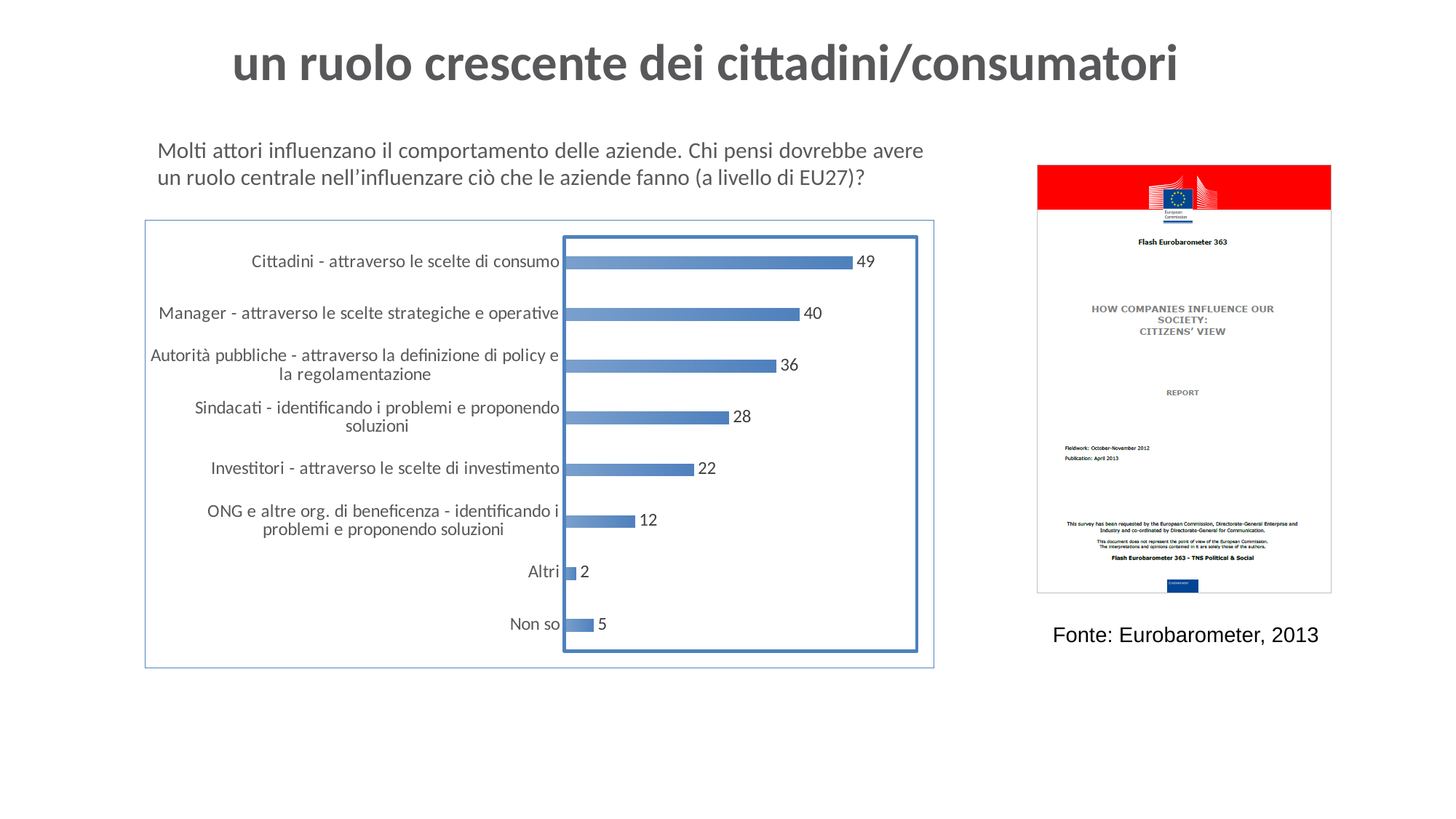
Which category has the highest value? Cittadini - attraverso le scelte di consumo What is the value for "Cittadini - attraverso le scelte di consumo"? 49 What is the value for "Investitori - attraverso le scelte di investimento"? 22 What is the value for "Manager - attraverso le scelte strategiche e operative"? 40 Which is larger: the value for "Autorità pubbliche" or the value for "Sindacati"? Autorità pubbliche What is the value for "Non so"? 5 Which category has the lowest value? Altri How many categories are shown in the chart? 8 What source is cited for the chart data? Eurobarometer, 2013 What is the difference between the values for "Sindacati" and "ONG e altre org. di beneficenza"? 16 What is the difference between the values for "Cittadini - attraverso le scelte di consumo" and "Manager - attraverso le scelte strategiche e operative"? 9 What kind of chart is shown on the slide? Bar chart